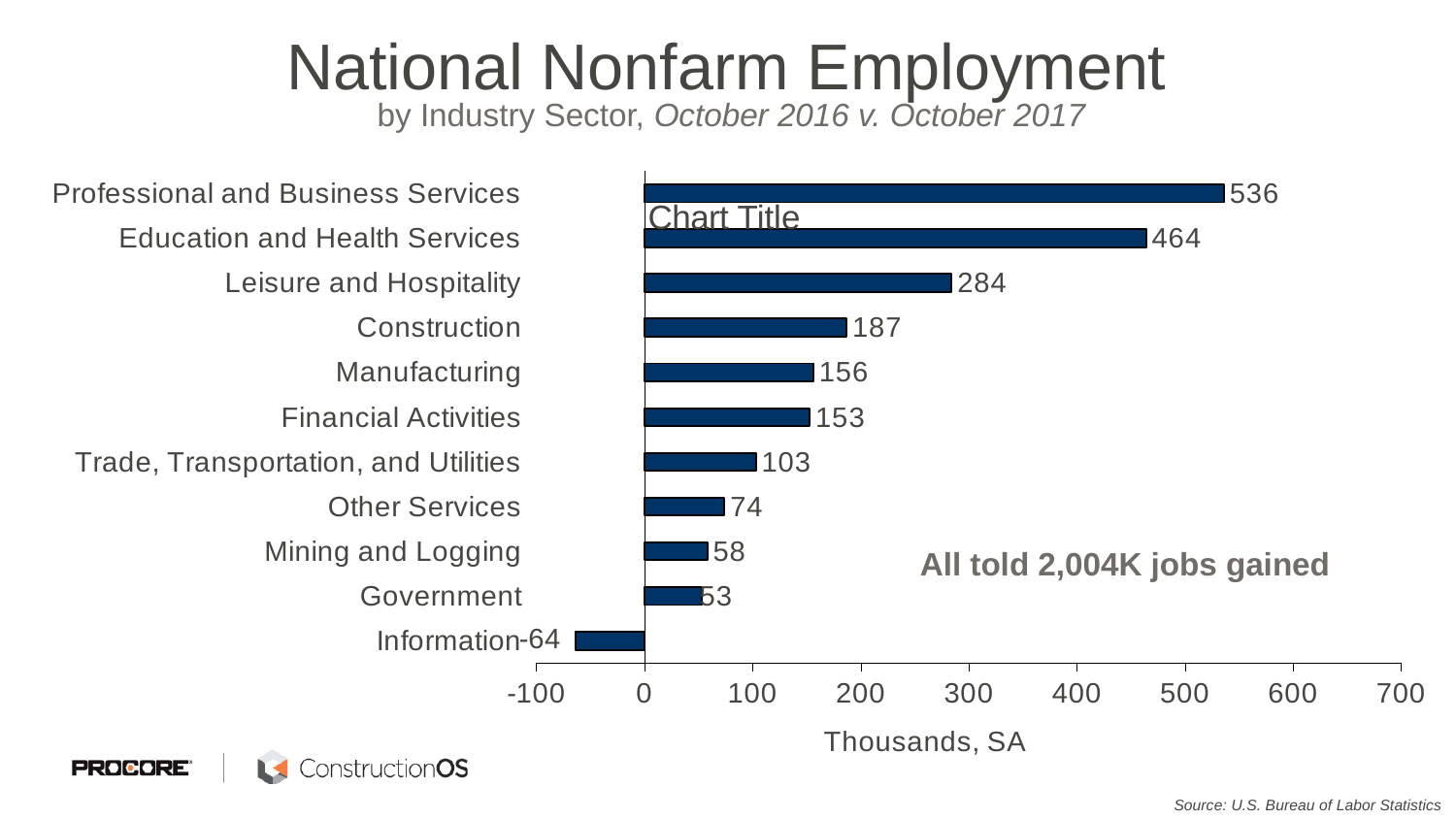
What is the difference between the values for Professional and Business Services and Education and Health Services? 72 Is the value for Education and Health Services greater or less than 400? greater What is the value for Trade, Transportation, and Utilities? 103 What is the difference between the values for Mining and Logging and Government? 5 Which industry sector has the highest value? Professional and Business Services How many industry sectors are shown in the chart? 11 What is the value for Information? -64 What is the value for Construction? 187 Which is larger, the value for Leisure and Hospitality or the value for Construction? Leisure and Hospitality Which industry sector has the lowest value? Information What is the label on the horizontal axis? Thousands, SA What kind of chart is shown on the slide? bar chart